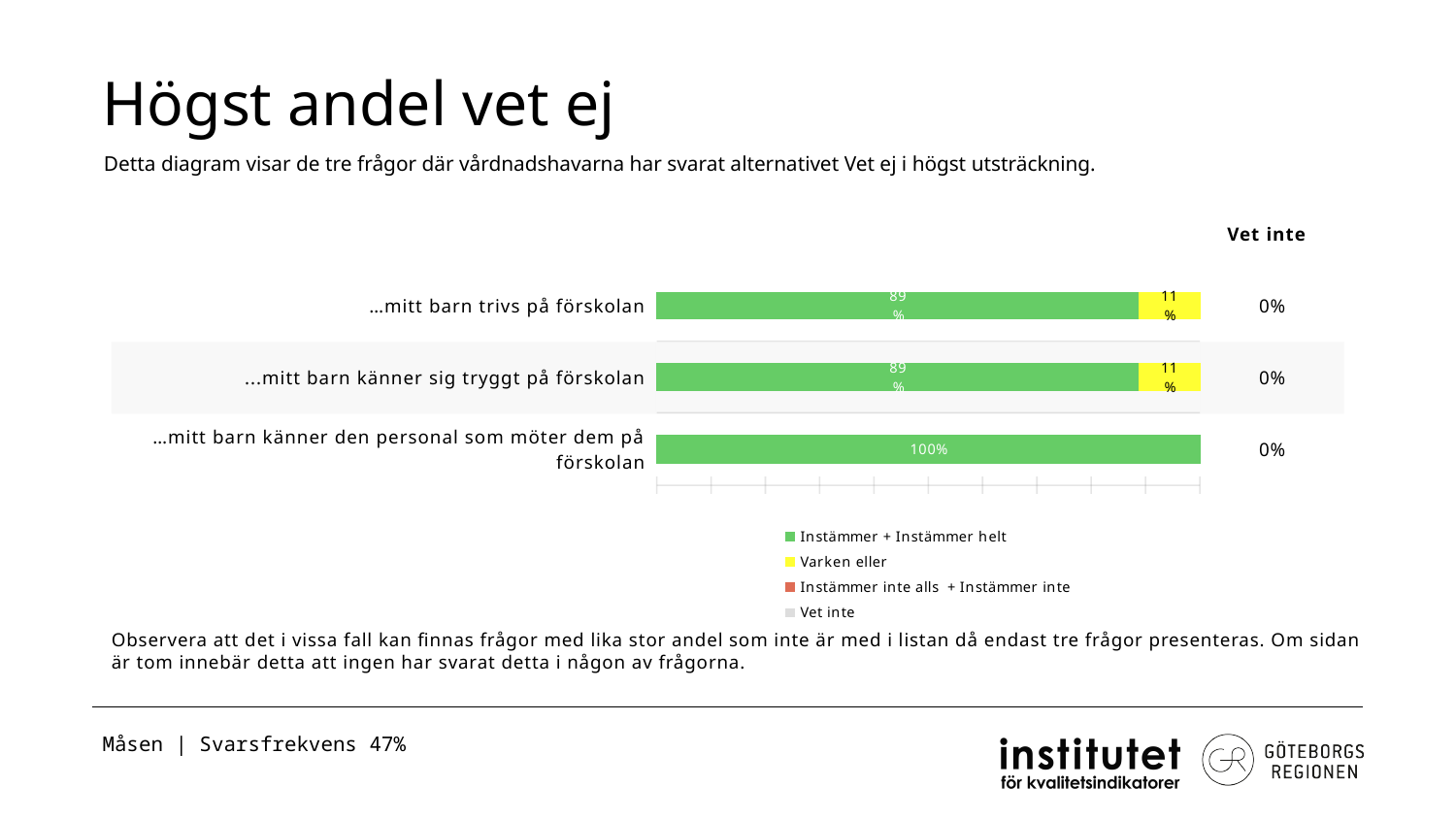
What is the value of 'Instämmer + Instämmer helt' for '…mitt barn trivs på förskolan'? 89% How many series does the legend list? 4 Which category has the highest 'Instämmer + Instämmer helt' value? …mitt barn känner den personal som möter dem på förskolan What is the difference between the 'Instämmer + Instämmer helt' value for '…mitt barn känner den personal som möter dem på förskolan' and for '…mitt barn trivs på förskolan'? 11% Which is larger for '…mitt barn trivs på förskolan': the 'Instämmer + Instämmer helt' value or the 'Varken eller' value? Instämmer + Instämmer helt What is the value of 'Varken eller' for '…mitt barn känner sig tryggt på förskolan'? 11% How many categories (questions) are plotted in the chart? 3 What is the heading of the column of values shown to the right of the bars? Vet inte What is the value of 'Instämmer + Instämmer helt' for '…mitt barn känner den personal som möter dem på förskolan'? 100% What is the 'Vet inte' value shown for '…mitt barn trivs på förskolan'? 0% What kind of chart is shown on the slide? Stacked bar chart What is the total of the stacked bar for '…mitt barn känner sig tryggt på förskolan'? 100%